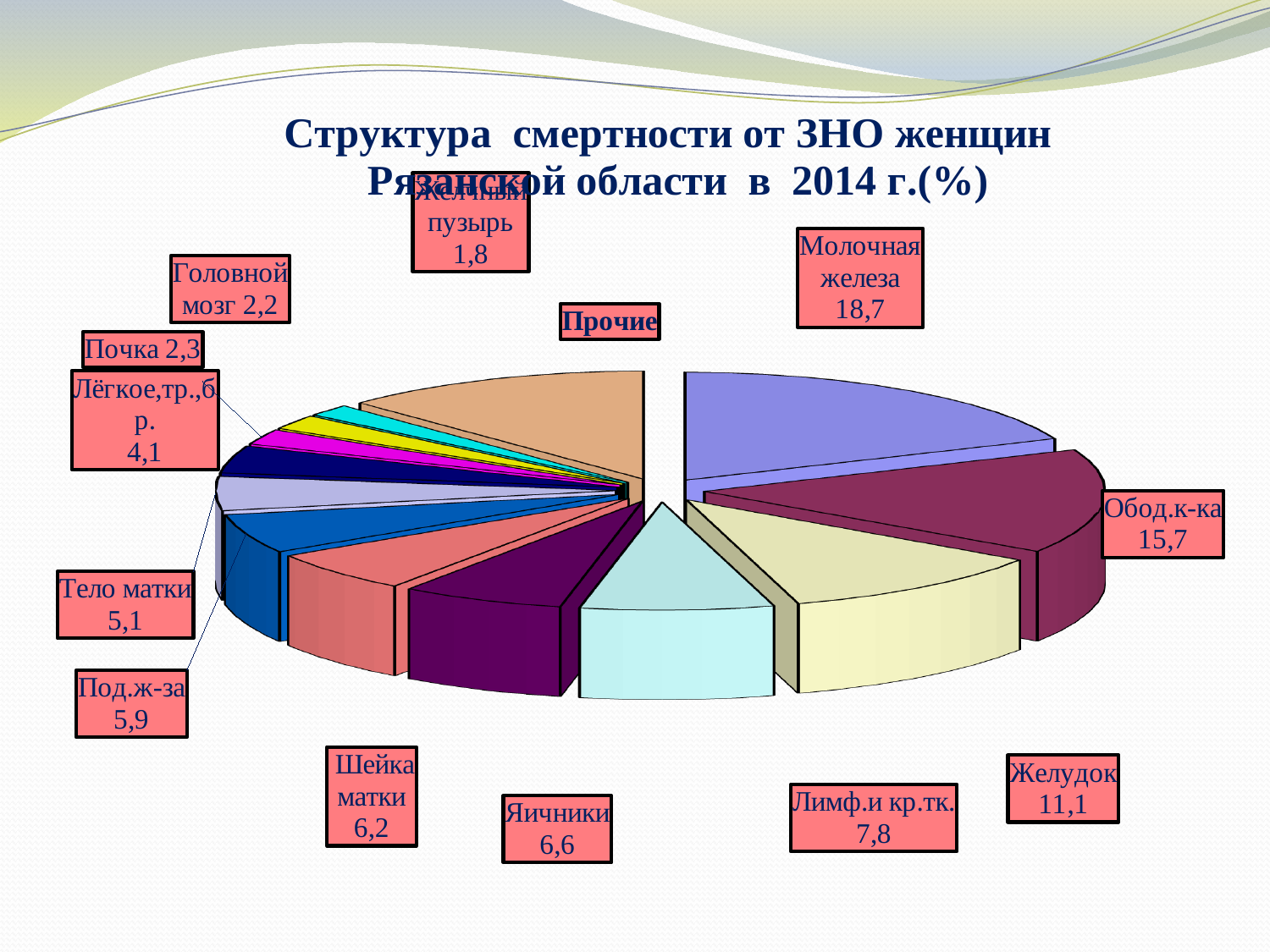
What year does the chart title refer to? 2014 What is the value for Шейка матки? 6,2 What is the value for Обод.к-ка? 15,7 What is the value for Тело матки? 5,1 What is the value for Молочная железа? 18,7 What is the value for Почка? 2,3 What is the value for Лимф.и кр.тк.? 7,8 What is the difference between the values for Молочная железа and Обод.к-ка? 3,0 What type of chart is shown on the slide? pie chart Which labelled category has the highest value? Молочная железа Which is larger, the value for Яичники or the value for Шейка матки? Яичники What is the value for Желудок? 11,1